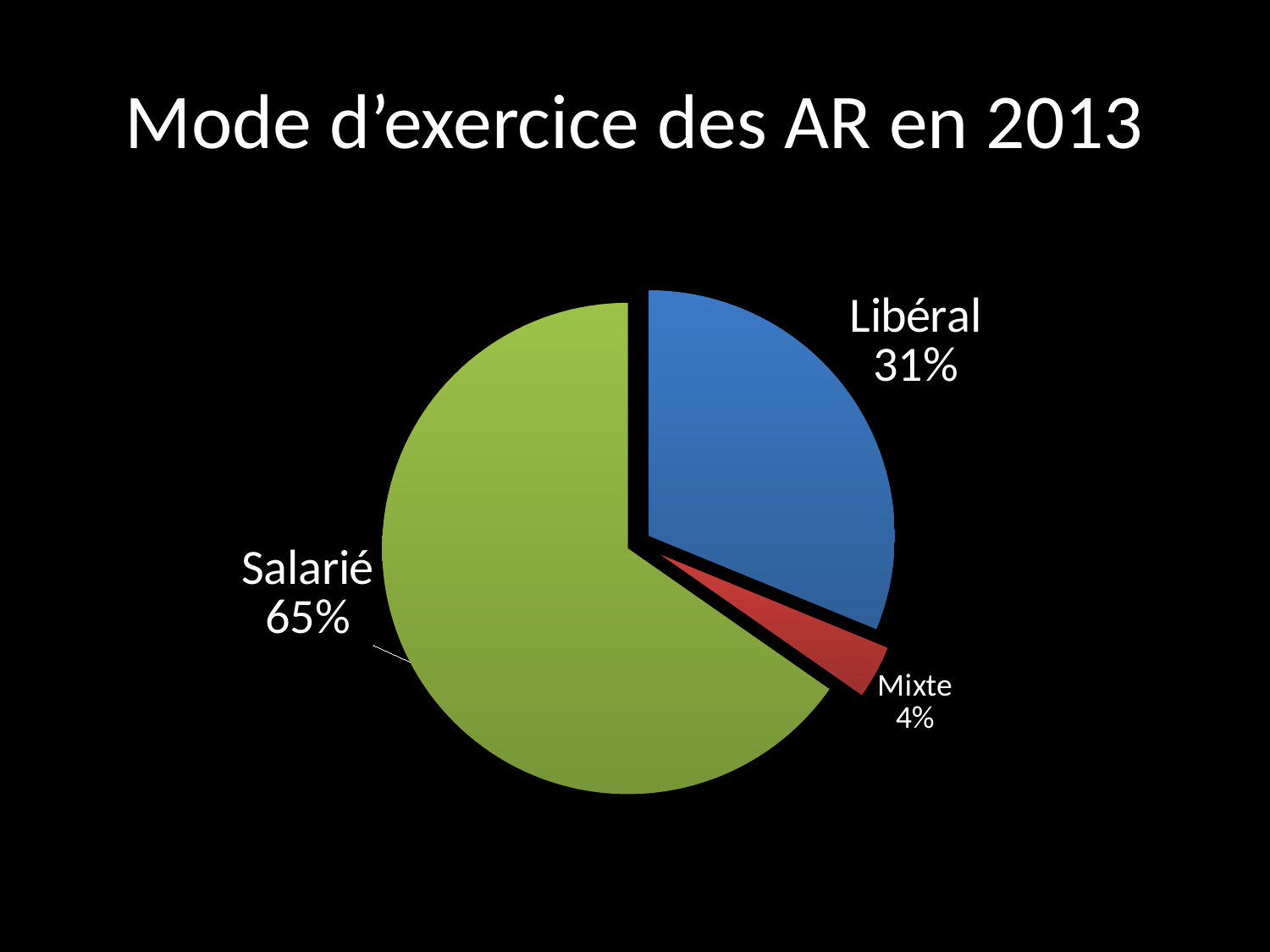
How many categories are shown in the pie chart? 3 What is the difference in percentage points between Libéral and Mixte? 27 Which is larger, the Libéral slice or the Mixte slice? Libéral What is the title of the chart? Mode d'exercice des AR en 2013 What share of the pie does Libéral represent? 31% What kind of chart is shown on the slide? Pie chart Which category has the smallest slice of the pie? Mixte What share of the pie does Mixte represent? 4% Which category has the largest slice of the pie? Salarié What is the difference in percentage points between Salarié and Libéral? 34 What share of the pie does Salarié represent? 65% What colour is the Salarié slice? Green